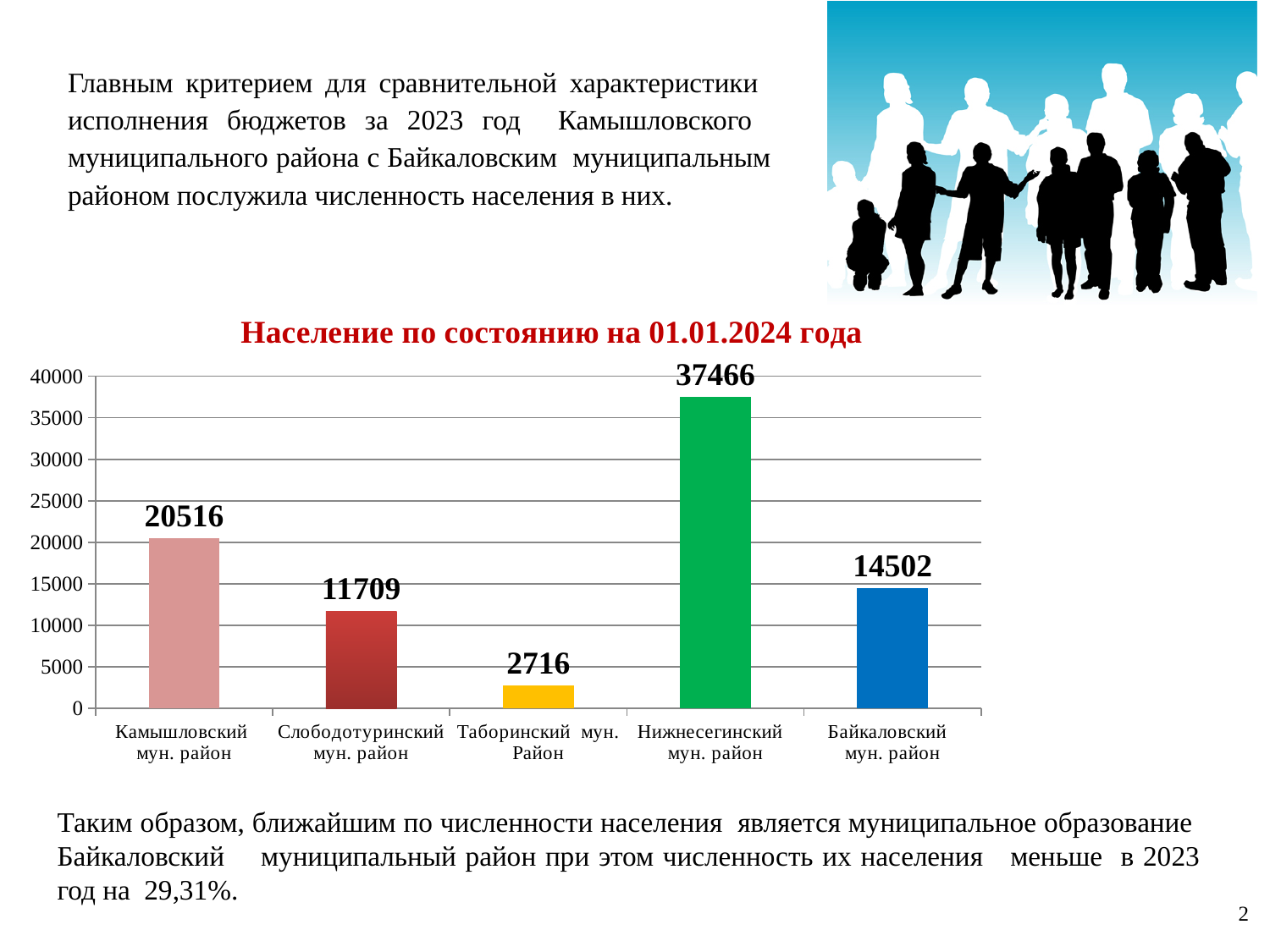
What is the population shown for Байкаловский мун. район? 14502 What is the difference in population between Камышловский мун. район and Байкаловский мун. район? 6014 Which district has the highest population in the chart? Нижнесегинский мун. район What is the population shown for Камышловский мун. район? 20516 What is the title of the chart? Население по состоянию на 01.01.2024 года Is the value for Нижнесегинский мун. район greater or less than 35000? greater What type of chart is shown on the slide? bar chart What is the difference in population between Нижнесегинский мун. район and Слободотуринский мун. район? 25757 Which has a larger population, Слободотуринский мун. район or Байкаловский мун. район? Байкаловский мун. район Which district has the lowest population in the chart? Таборинский мун. Район What is the population shown for Таборинский мун. Район? 2716 How many districts are shown in the chart? 5